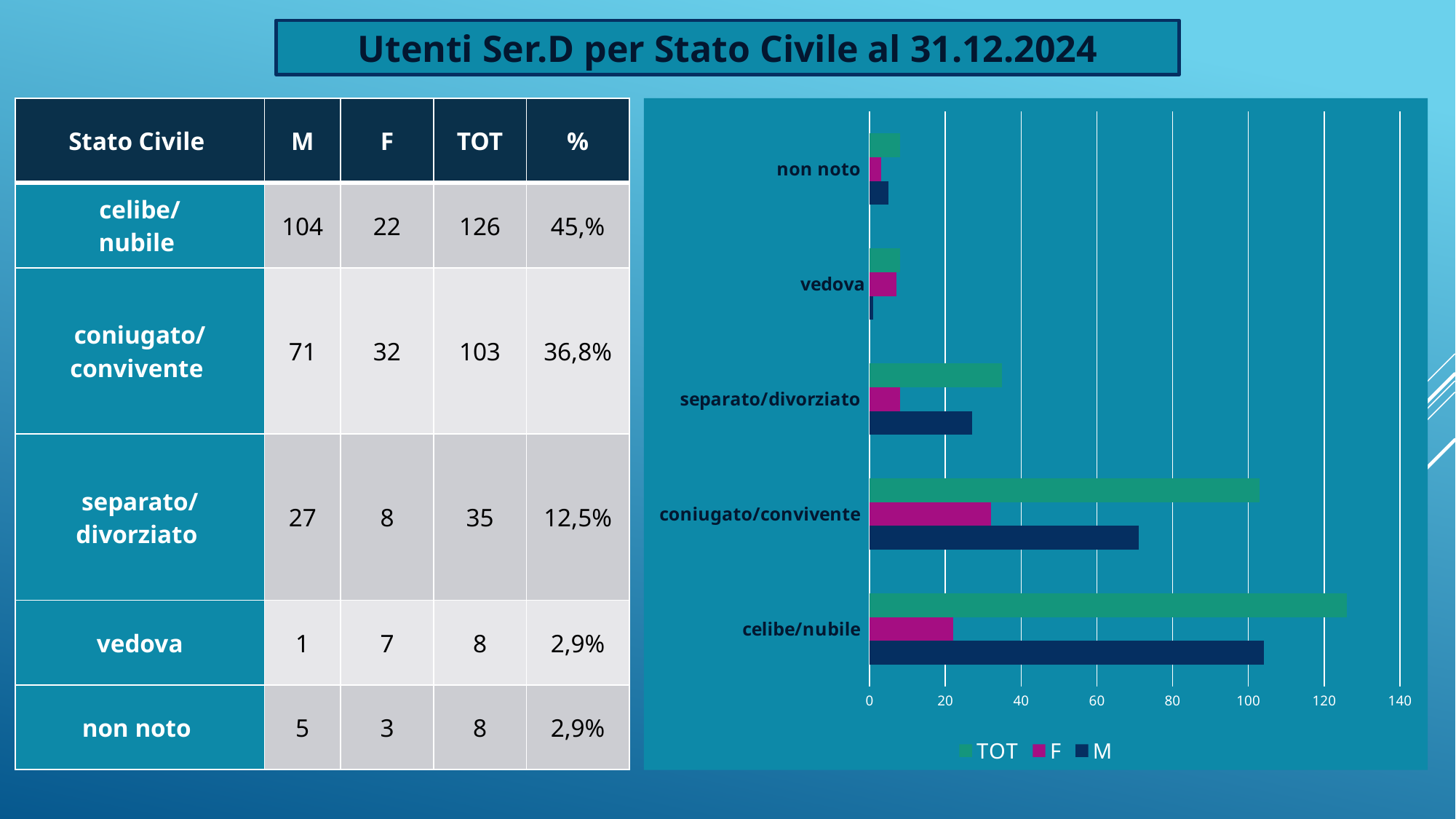
Which is larger, the F value for vedova or the F value for non noto? vedova How many marital status categories are plotted on the chart? 5 Is the TOT value for celibe/nubile greater or less than 120? greater How many series does the chart legend list? 3 What is the TOT value for separato/divorziato? 35 What is the F value for coniugato/convivente? 32 What is the M value for celibe/nubile? 104 Which category has the lowest M value? vedova Which category has the highest TOT value? celibe/nubile Is the M value for coniugato/convivente greater or less than 80? less What is the difference between the TOT values for celibe/nubile and coniugato/convivente? 23 What kind of chart is shown on the slide? bar chart